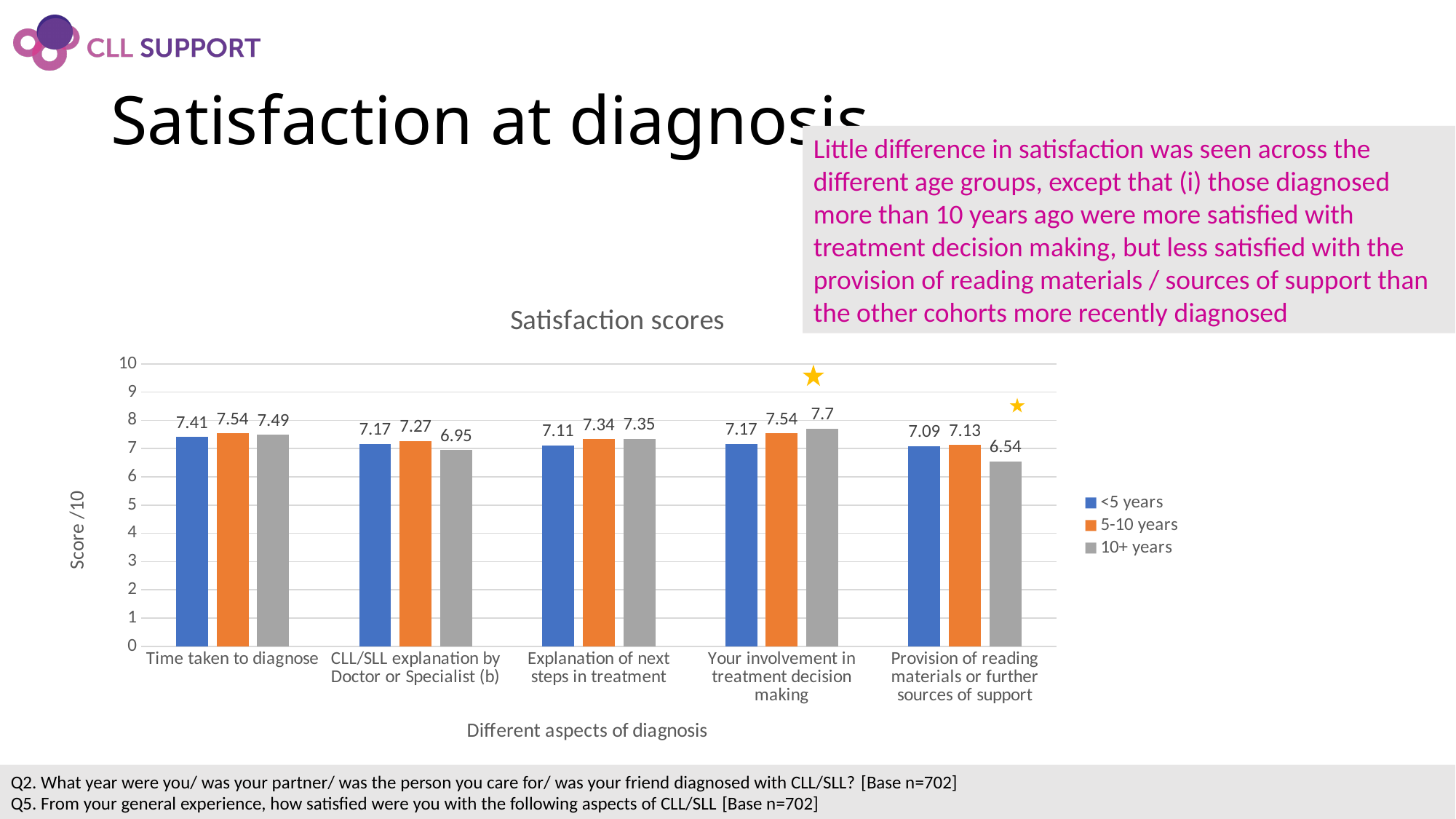
For 'CLL/SLL explanation by Doctor or Specialist (b)', which series has the larger score: '5-10 years' or '10+ years'? 5-10 years What is the satisfaction score for '<5 years' on 'Time taken to diagnose'? 7.41 What is the difference between the '10+ years' and '<5 years' scores for 'Your involvement in treatment decision making'? 0.53 What is the satisfaction score for '5-10 years' on 'Explanation of next steps in treatment'? 7.34 How many aspects of diagnosis are shown on the x axis? 5 What is the satisfaction score for '10+ years' on 'Provision of reading materials or further sources of support'? 6.54 Which aspect has the lowest score for the '10+ years' series? Provision of reading materials or further sources of support How many series does the legend list? 3 What is the title of the chart? Satisfaction scores Is the '10+ years' score for 'Provision of reading materials or further sources of support' greater or less than 7? less Which aspect has the highest score for the '10+ years' series? Your involvement in treatment decision making What kind of chart is shown on the slide? Bar chart